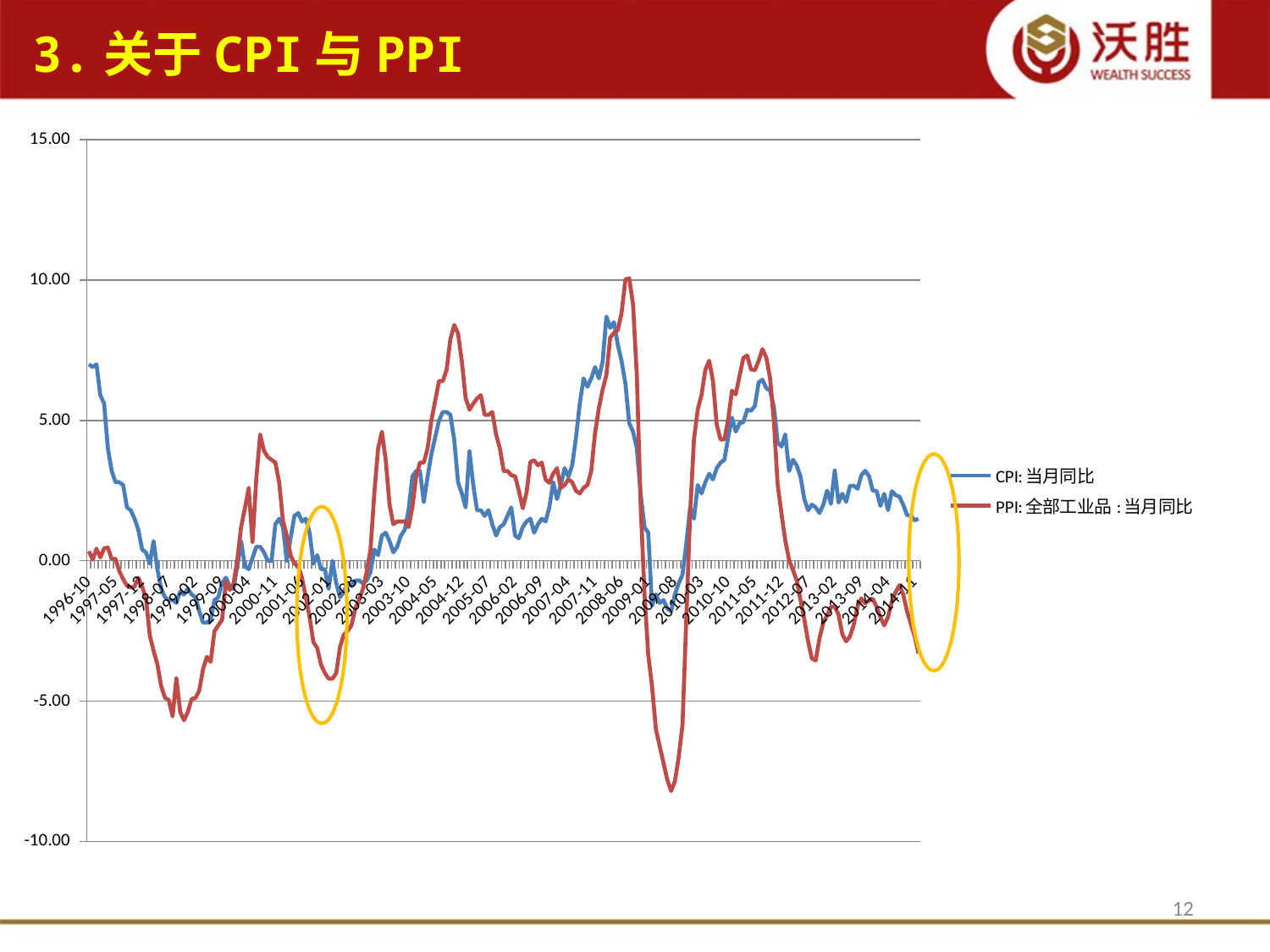
Is the value of the CPI: 当月同比 series at 1996-10 greater or less than 5.00? greater Does the CPI: 当月同比 series rise or fall between 1996-10 and 1997-05? fall Is the highest value reached by the CPI: 当月同比 series greater or less than 10.00? less What is the first label on the x axis? 1996-10 How many series does the legend list? 2 What kind of chart is shown on the slide? line chart Is the value of the PPI: 全部工业品:当月同比 series at 2014-11 greater or less than 0.00? less Which series reaches the highest value on the chart? PPI: 全部工业品:当月同比 What colour is the line for the CPI: 当月同比 series? blue Which series reaches the lowest value on the chart? PPI: 全部工业品:当月同比